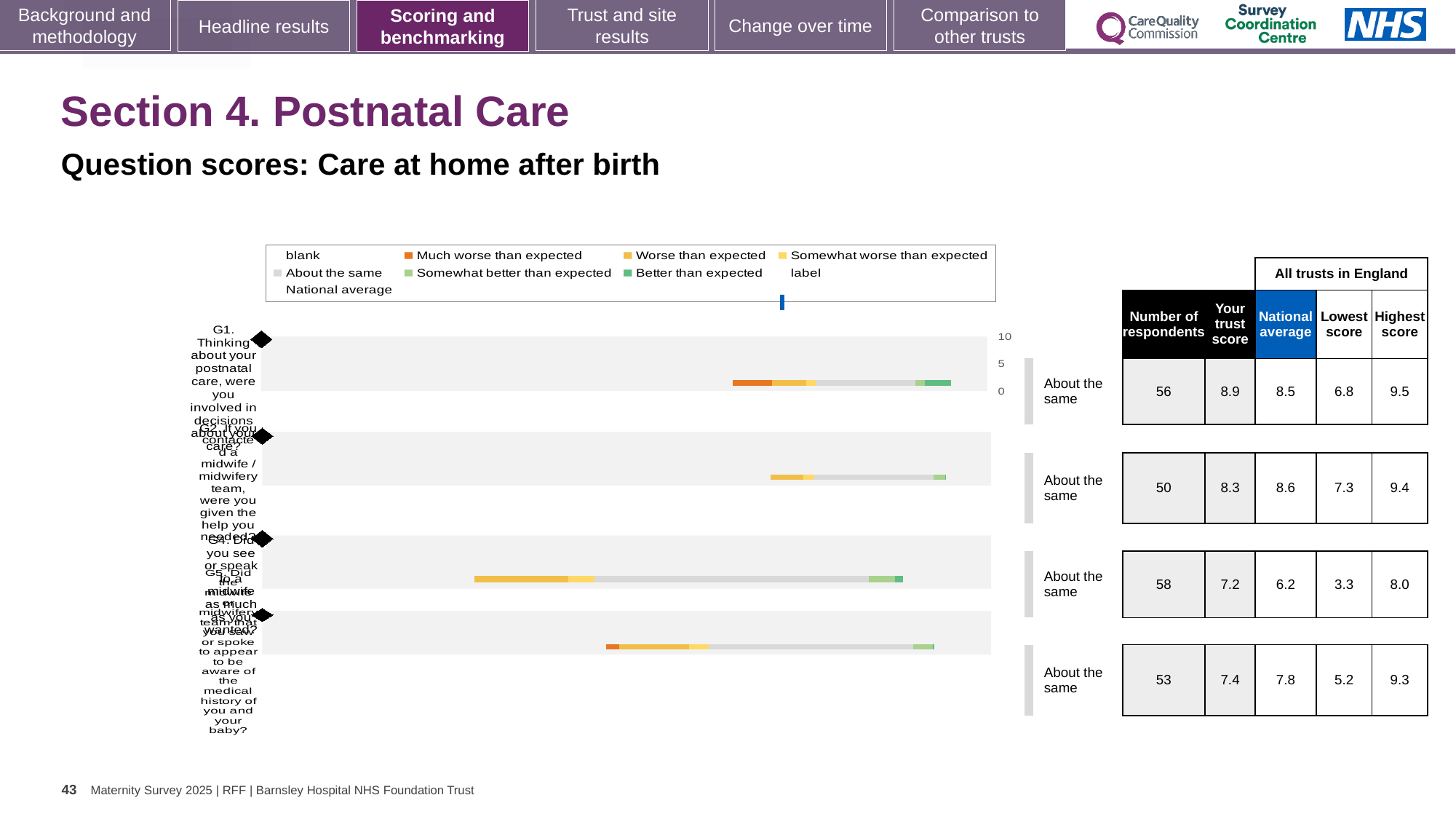
According to the table beside the chart, is the trust score for the fourth row (G5) larger or smaller than its national average? smaller What kind of chart is shown on the slide? bar chart According to the table beside the chart, what is the trust score for the first row (G1)? 8.9 According to the table beside the chart, which row has the lowest 'Lowest score' value? G4 (3.3) According to the table beside the chart, what is the national average for the third row (G4)? 6.2 According to the table beside the chart, which row has the highest 'Your trust score'? G1 (8.9) How many question rows (bars) are plotted in the chart? 4 In the chart legend, which colour represents 'Better than expected'? green What benchmark category is shown for every row in the chart? About the same According to the table beside the chart, what is the number of respondents for the second row (G2)? 50 In the chart legend, which colour represents 'Much worse than expected'? orange According to the table beside the chart, what is the difference between the trust score and the national average for the third row (G4)? 1.0